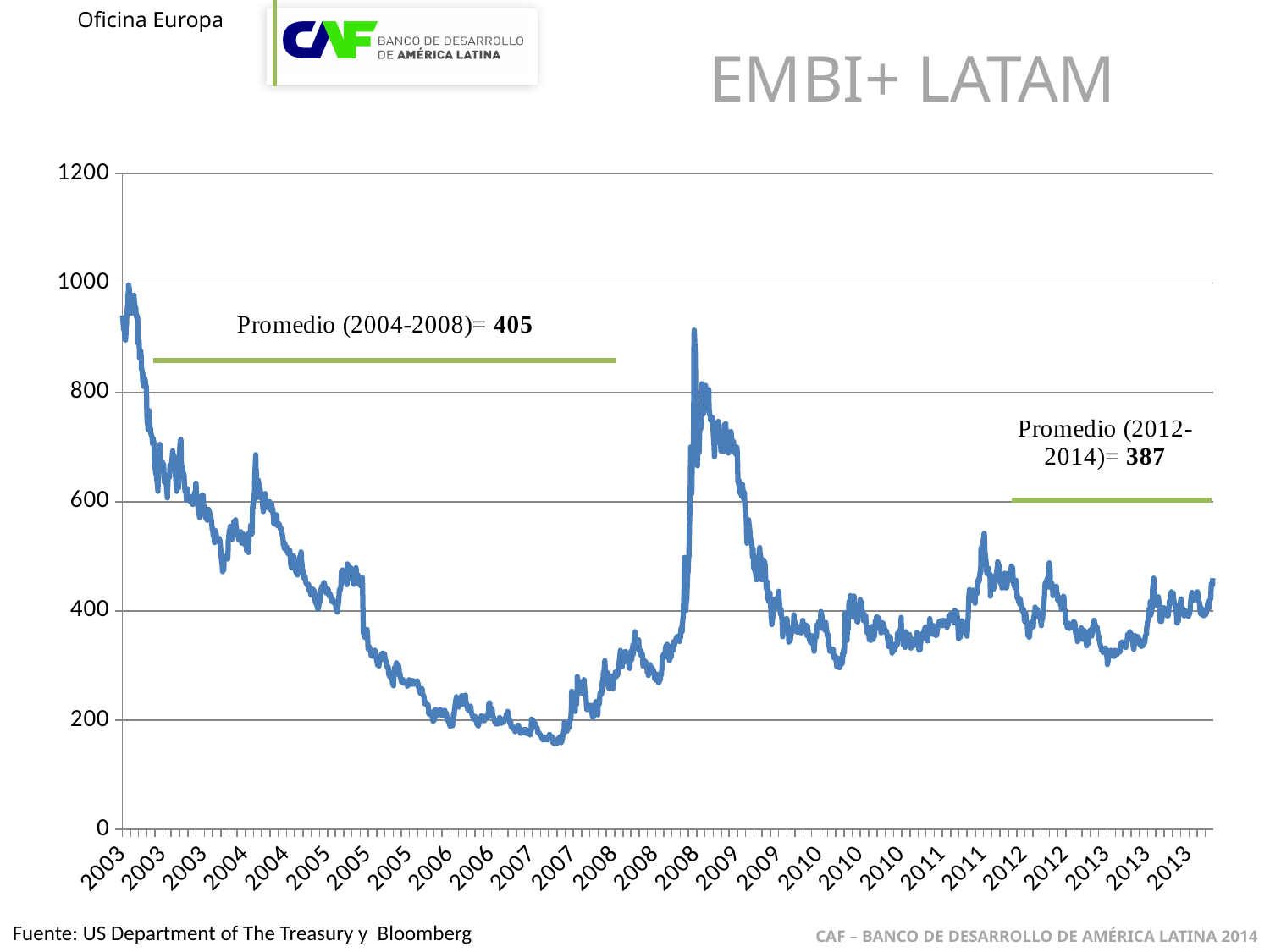
Which is larger, the 2004-2008 average or the 2012-2014 average? 2004-2008 average What is the highest value shown on the vertical axis? 1200 What is the difference between the 2004-2008 average and the 2012-2014 average? 18 Is the value at the start of 2003 greater or less than 800? greater What kind of chart is shown on the slide? line chart What is the title of the chart? EMBI+ LATAM Is the lowest value reached in 2007 greater or less than 200? less What is the average (Promedio) value shown for 2004-2008? 405 Does the line generally rise or fall from 2003 to 2007? fall What is the average (Promedio) value shown for 2012-2014? 387 Is the peak value reached in 2008 greater or less than 800? greater